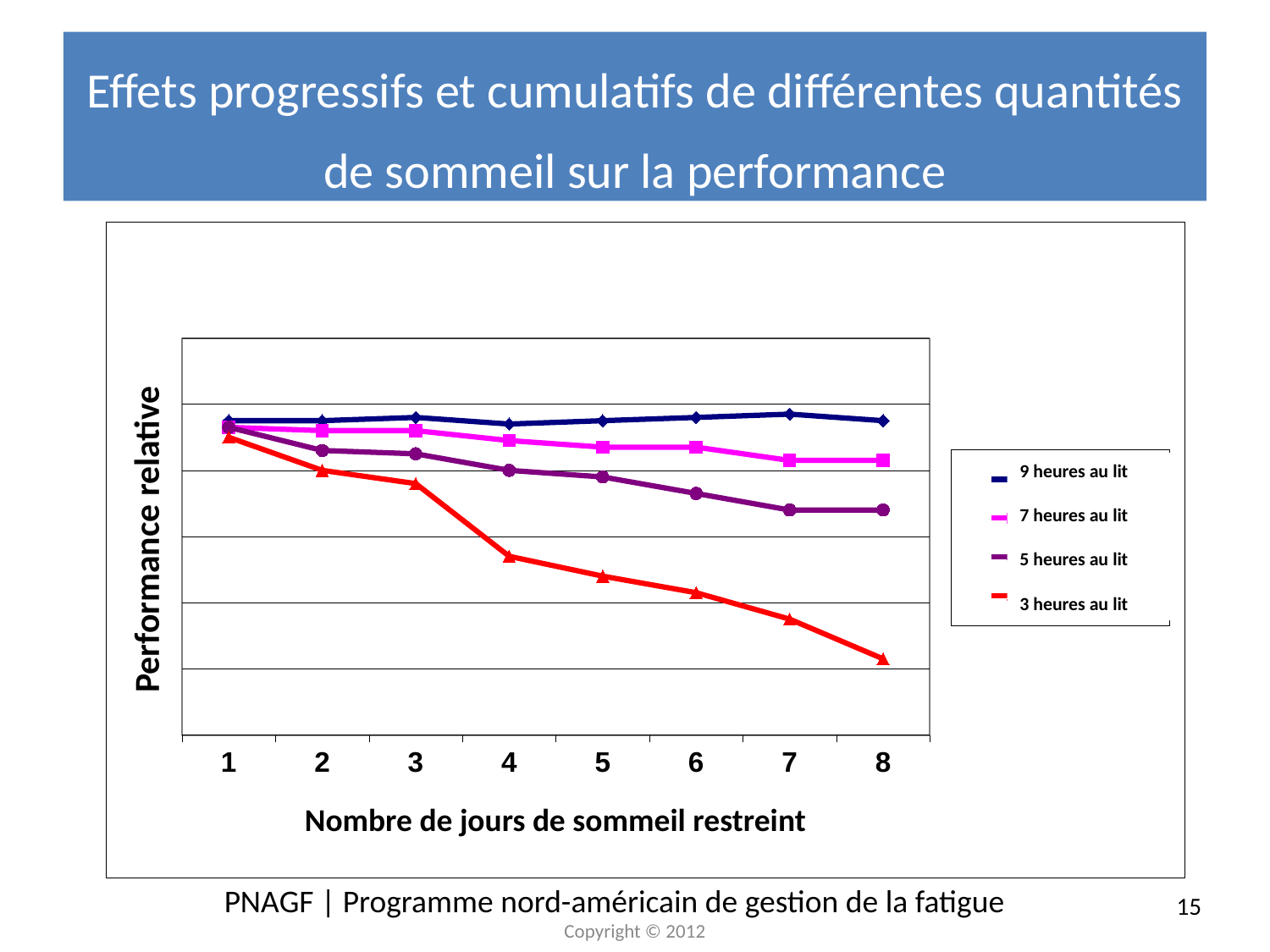
Which series has the lowest relative performance at day 8? 3 heures au lit At day 6, which is higher: the performance for '7 heures au lit' or for '3 heures au lit'? 7 heures au lit Which series shows the steepest decline over the 8 days? 3 heures au lit Does the performance for '5 heures au lit' rise or fall from day 1 to day 8? fall Does the performance for '3 heures au lit' rise or fall as the number of days increases? fall What is the title of the x axis? Nombre de jours de sommeil restreint At day 4, which is higher: the performance for '5 heures au lit' or for '3 heures au lit'? 5 heures au lit How many days are plotted along the x axis? 8 What colour is the line for '9 heures au lit'? dark blue Which series has the highest relative performance at day 8? 9 heures au lit How many series does the legend list? 4 What kind of chart is shown on the slide? line chart